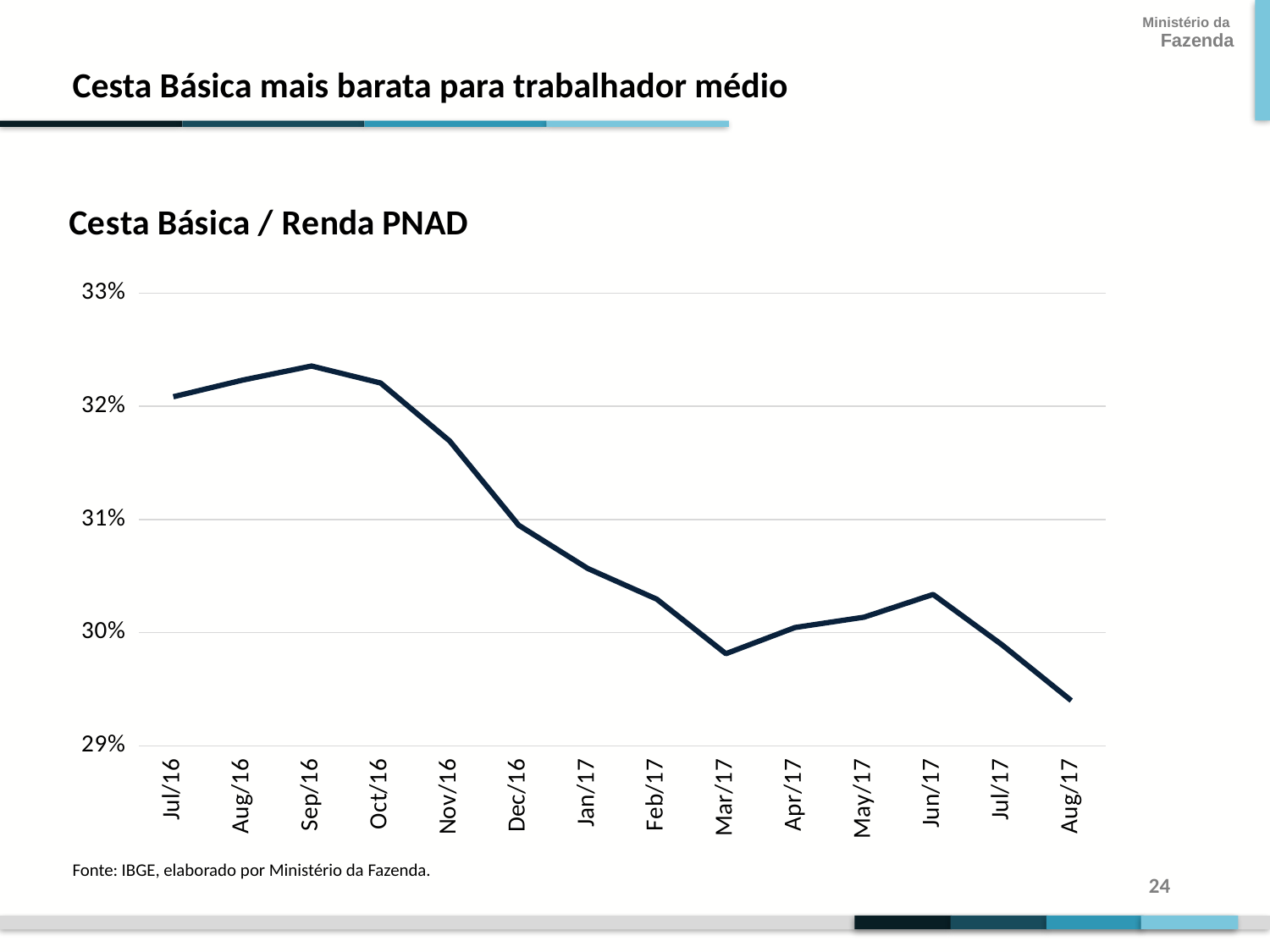
Which is larger, the value for Mar/17 or the value for Jun/17? Jun/17 Is the value for Nov/16 greater or less than 32%? less What is the title of the chart? Cesta Básica / Renda PNAD Is the value for Aug/17 greater or less than 30%? less Is the value for Sep/16 greater or less than 32%? greater Which month has the lowest value? Aug/17 Which month has the highest value? Sep/16 How many months are plotted on the x axis? 14 What kind of chart is shown on the slide? line chart Overall, do the values rise or fall from Jul/16 to Aug/17? fall Which is larger, the value for Jul/16 or the value for Aug/17? Jul/16